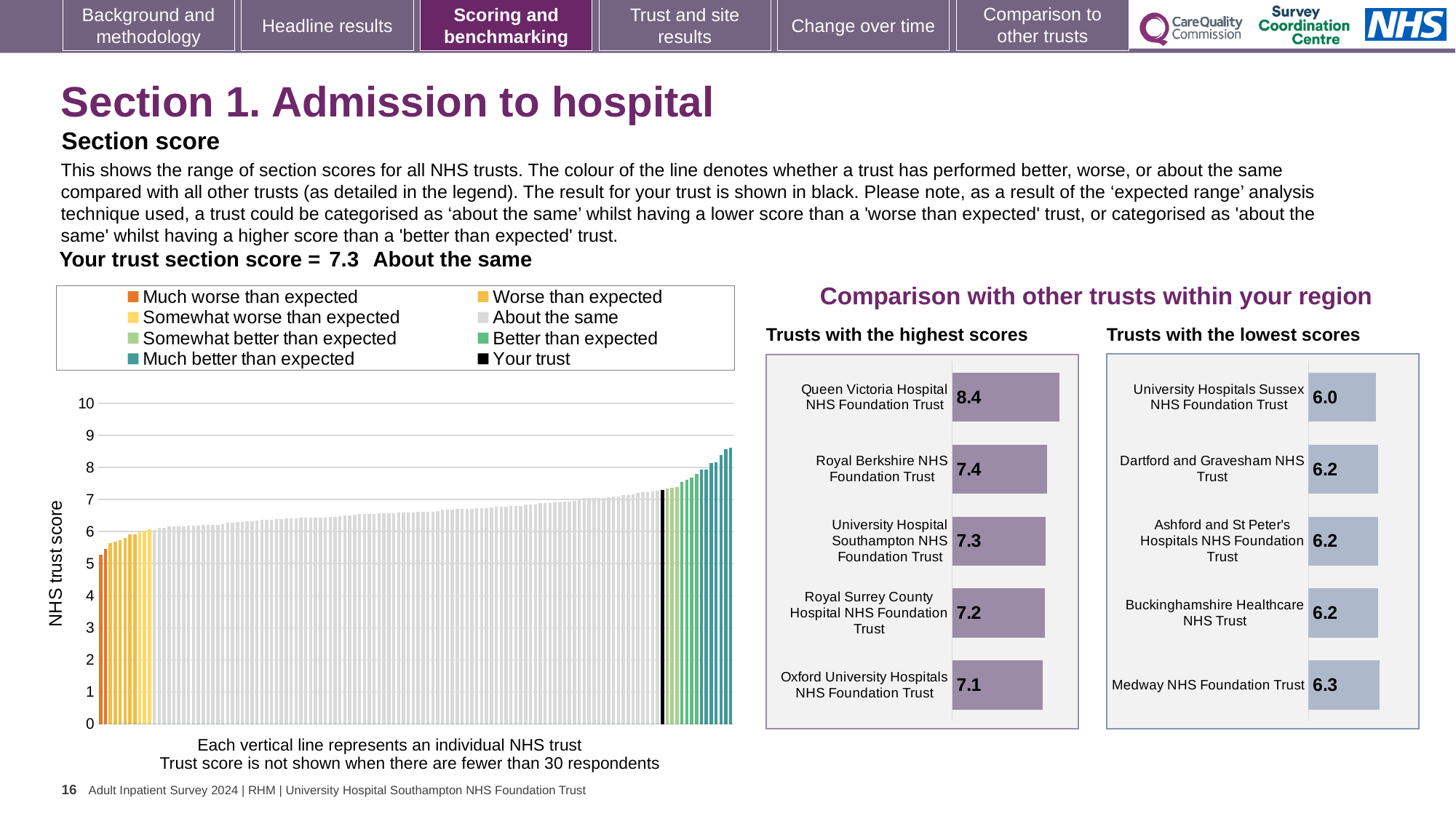
In the 'Trusts with the highest scores' chart, what is the score for Oxford University Hospitals NHS Foundation Trust? 7.1 In the 'Trusts with the lowest scores' chart, what is the score for Medway NHS Foundation Trust? 6.3 In the main NHS trust score chart on the left, do the values rise or fall from left to right? Rise In the 'Trusts with the highest scores' chart, what is the difference between the scores of Queen Victoria Hospital NHS Foundation Trust and Royal Berkshire NHS Foundation Trust? 1.0 In the 'Trusts with the lowest scores' chart, which trust has the lowest score? University Hospitals Sussex NHS Foundation Trust How many trusts are shown in the 'Trusts with the lowest scores' chart? 5 In the 'Trusts with the lowest scores' chart, which has the higher score: Medway NHS Foundation Trust or University Hospitals Sussex NHS Foundation Trust? Medway NHS Foundation Trust In the 'Trusts with the highest scores' chart, what is the score for Queen Victoria Hospital NHS Foundation Trust? 8.4 How many entries does the legend of the main NHS trust score chart list? 8 What kind of chart is the main chart showing NHS trust scores on the left of the slide? Bar chart In the main NHS trust score chart on the left, is the value of the leftmost (lowest) bar greater or less than 6? less In the 'Trusts with the highest scores' chart, which trust has the highest score? Queen Victoria Hospital NHS Foundation Trust